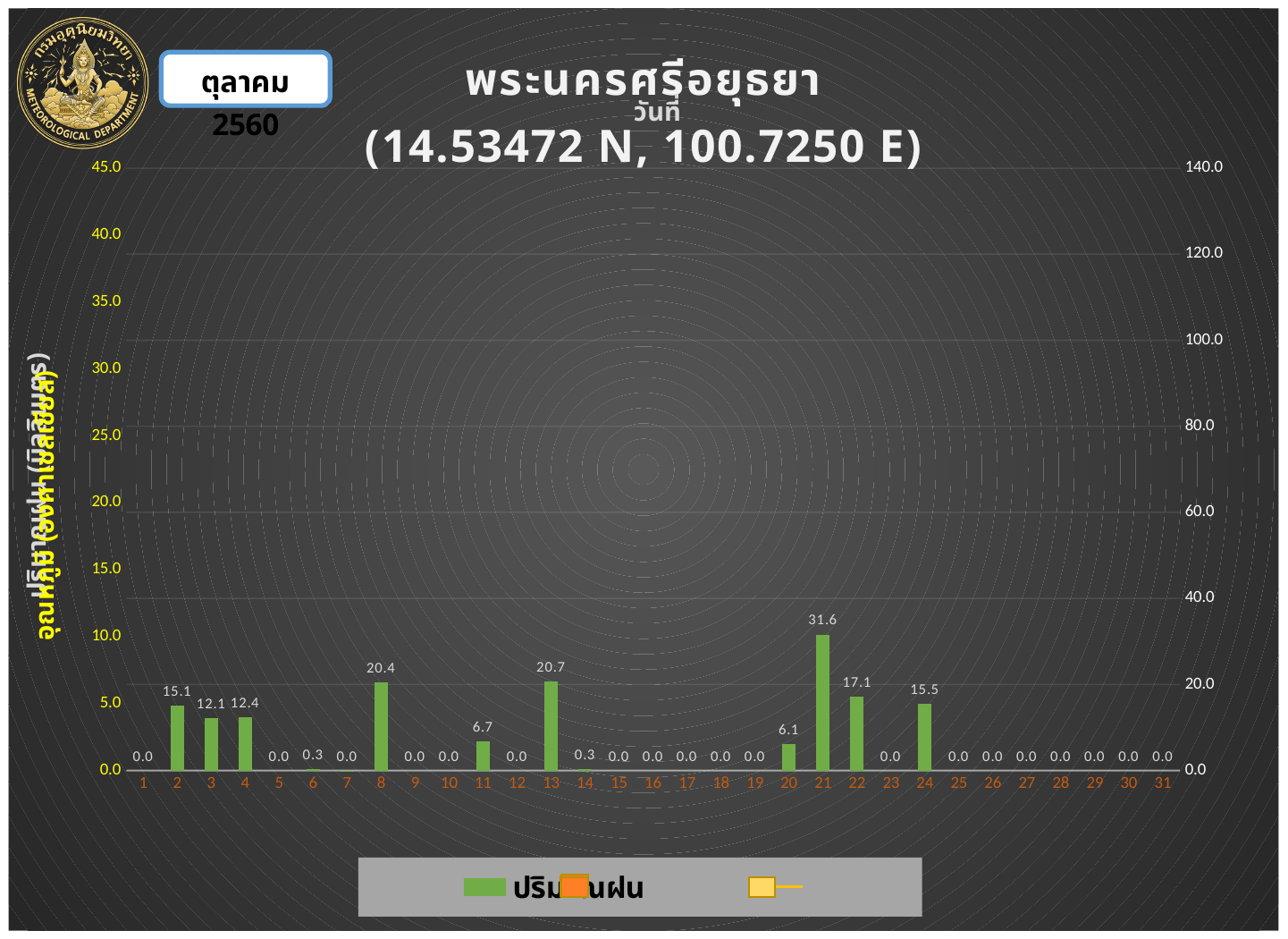
How many days are shown on the x axis? 31 What is the value for day 24? 15.5 What is the difference between the values for day 21 and day 22? 14.5 What is the difference between the values for day 2 and day 3? 3.0 What is the value for day 8? 20.4 Which is larger, the value for day 8 or the value for day 13? day 13 What is the value for day 6? 0.3 What is the value for day 13? 20.7 What kind of chart is shown on the slide? bar chart What is the value for day 21? 31.6 Which is larger, the value for day 11 or the value for day 20? day 11 Which day has the highest value? 21